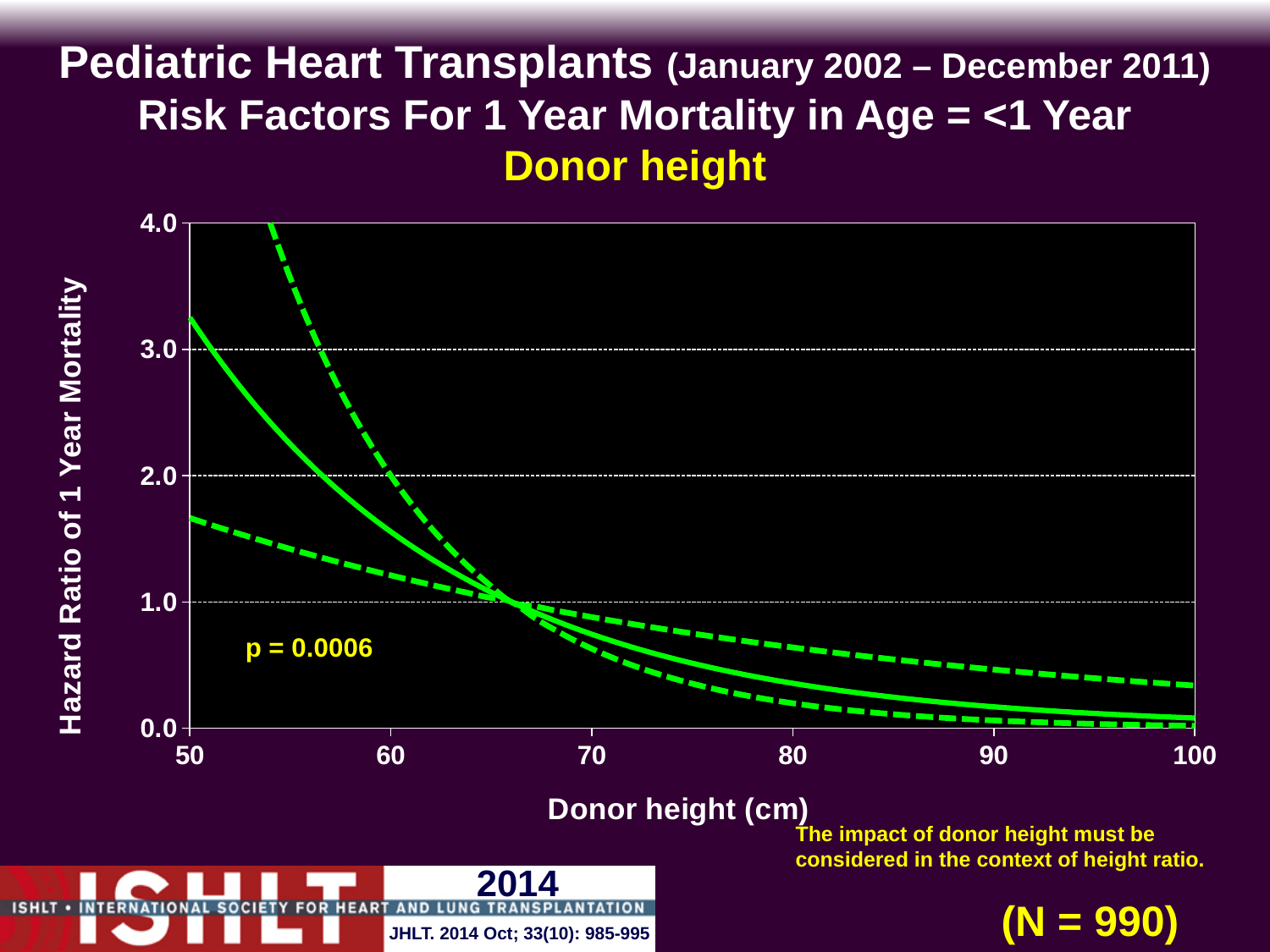
What is the highest value labelled on the y axis? 4.0 Is the hazard ratio on the solid line at a donor height of 100 cm greater or less than 1.0? less What is the label of the x axis? Donor height (cm) Does the hazard ratio rise or fall as donor height increases along the x axis? fall How many lines are plotted on the chart? 3 What kind of chart is shown on the slide? line chart Is the hazard ratio on the solid line at a donor height of 60 cm greater or less than 1.0? greater What p-value is printed on the chart? p = 0.0006 How many tick labels are shown on the x axis? 6 Is the hazard ratio on the solid line at a donor height of 60 cm greater or less than 2.0? less